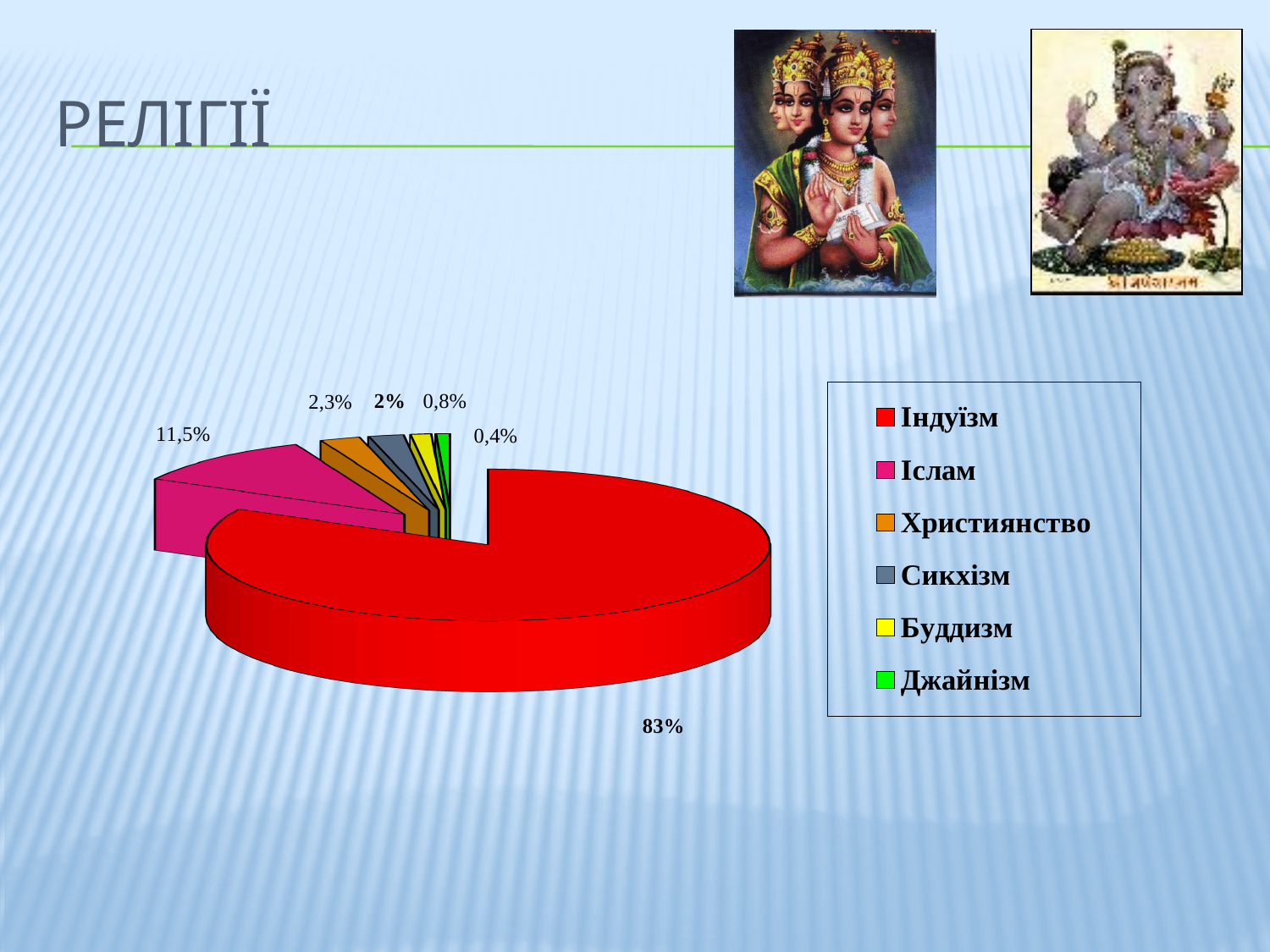
What is the value shown for Джайнізм? 0,4% What share of the pie does Індуїзм have? 83% What is the value shown for Сикхізм? 2% How many categories does the legend list? 6 Which is larger, the share of Християнство or the share of Буддизм? Християнство What is the value shown for Буддизм? 0,8% Which religion has the largest slice of the pie? Індуїзм What is the value shown for Іслам? 11,5% What is the value shown for Християнство? 2,3% What is the difference between the shares of Індуїзм and Іслам? 71,5% Which religion has the smallest slice of the pie? Джайнізм What kind of chart is shown on the slide? Pie chart